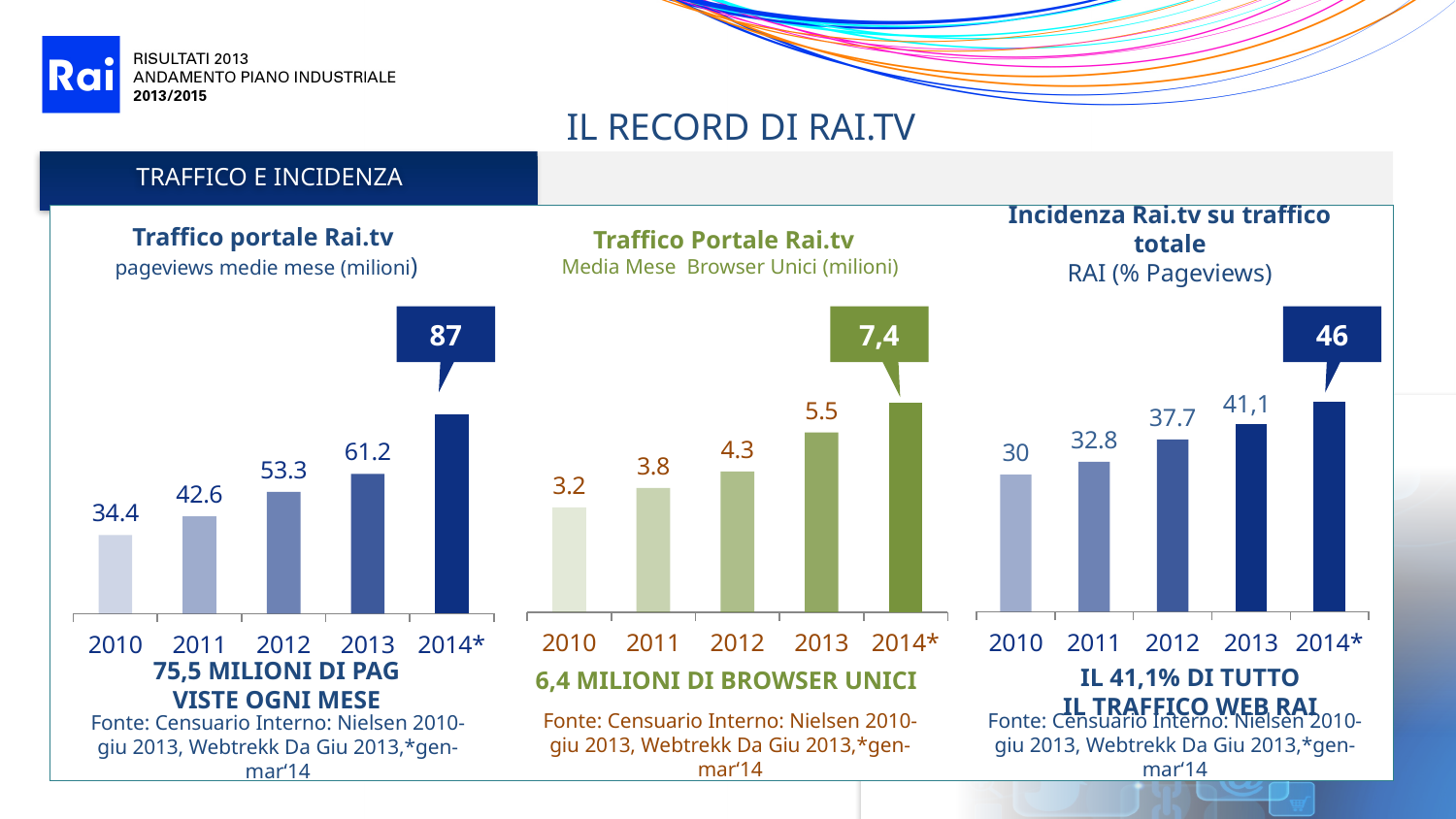
What kind of chart is the right chart (Incidenza Rai.tv su traffico totale RAI)? bar chart In the middle chart (Traffico Portale Rai.tv, Media Mese Browser Unici), which year has the lowest value? 2010 In the right chart (Incidenza Rai.tv su traffico totale RAI), what is the value for 2013? 41,1 In the left chart (Traffico portale Rai.tv, pageviews medie mese), what is the value for 2014*? 87 In the middle chart (Traffico Portale Rai.tv, Media Mese Browser Unici), which year has the highest value? 2014* How many years are shown on the x axis of the left chart (Traffico portale Rai.tv, pageviews medie mese)? 5 In the middle chart (Traffico Portale Rai.tv, Media Mese Browser Unici), do the values rise or fall from 2010 to 2014*? rise In the right chart (Incidenza Rai.tv su traffico totale RAI), which is larger, the value for 2011 or the value for 2012? 2012 In the right chart (Incidenza Rai.tv su traffico totale RAI), what is the value for 2010? 30 In the middle chart (Traffico Portale Rai.tv, Media Mese Browser Unici), what is the value for 2011? 3.8 In the left chart (Traffico portale Rai.tv, pageviews medie mese), what is the value for 2012? 53.3 In the left chart (Traffico portale Rai.tv, pageviews medie mese), what is the difference between the 2013 and 2010 values? 26.8